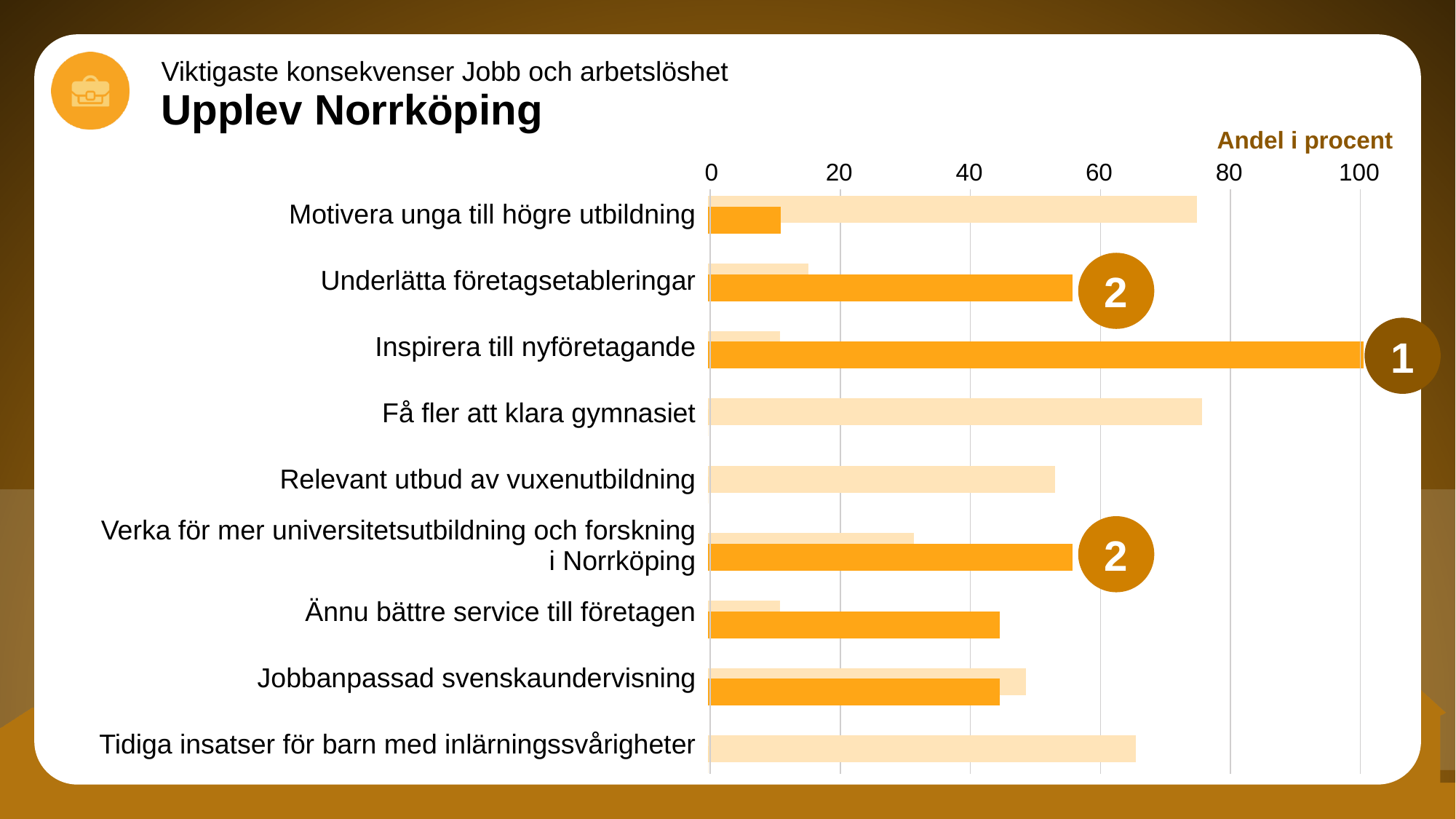
Is the light orange bar for Få fler att klara gymnasiet greater or less than 60? greater Which has the longer dark orange bar: Underlätta företagsetableringar or Ännu bättre service till företagen? Underlätta företagsetableringar Is the light orange bar for Tidiga insatser för barn med inlärningssvårigheter greater or less than 60? greater Is the dark orange bar for Motivera unga till högre utbildning greater or less than 20? less What kind of chart is shown on the slide? bar chart What label is shown above the horizontal axis of the chart? Andel i procent Which category has the longest dark orange bar? Inspirera till nyföretagande Which category is marked with the circled number 1? Inspirera till nyföretagande What value does the dark orange bar for Inspirera till nyföretagande reach on the axis? 100 How many categories are listed on the chart? 9